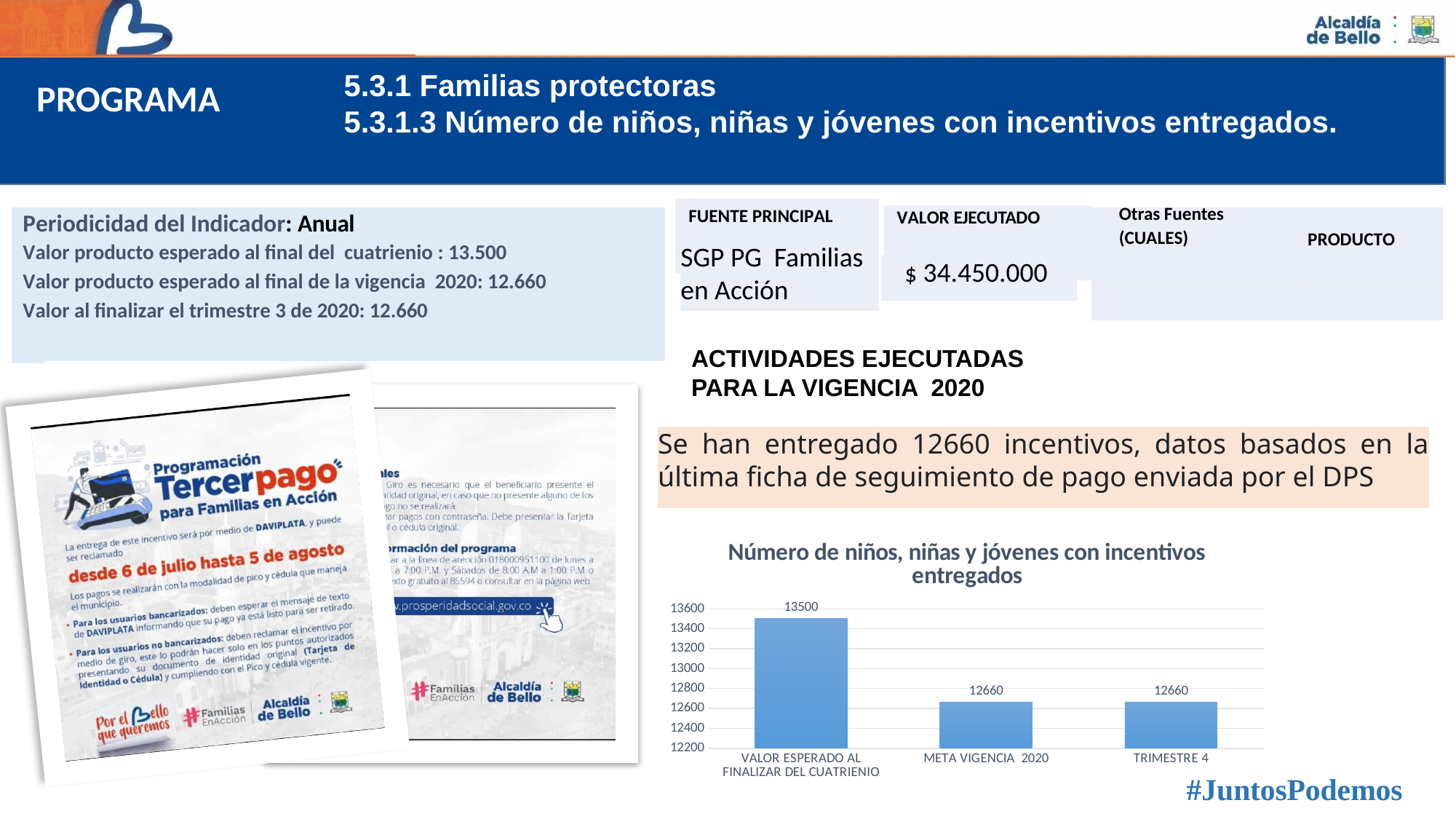
What is the value for VALOR ESPERADO AL FINALIZAR DEL CUATRIENIO? 13500 Which category has the highest value? VALOR ESPERADO AL FINALIZAR DEL CUATRIENIO What is the value for META VIGENCIA 2020? 12660 How many categories are shown on the chart? 3 Is the value for TRIMESTRE 4 greater or less than 13000? less Do the values for META VIGENCIA 2020 and TRIMESTRE 4 differ from each other? No, both are 12660 What is the value for TRIMESTRE 4? 12660 Is the value for VALOR ESPERADO AL FINALIZAR DEL CUATRIENIO greater or less than 13400? greater What kind of chart is shown on the slide? bar chart What is the difference between the value for VALOR ESPERADO AL FINALIZAR DEL CUATRIENIO and the value for META VIGENCIA 2020? 840 Which is larger, the value for VALOR ESPERADO AL FINALIZAR DEL CUATRIENIO or the value for TRIMESTRE 4? VALOR ESPERADO AL FINALIZAR DEL CUATRIENIO What is the title of the chart? Número de niños, niñas y jóvenes con incentivos entregados